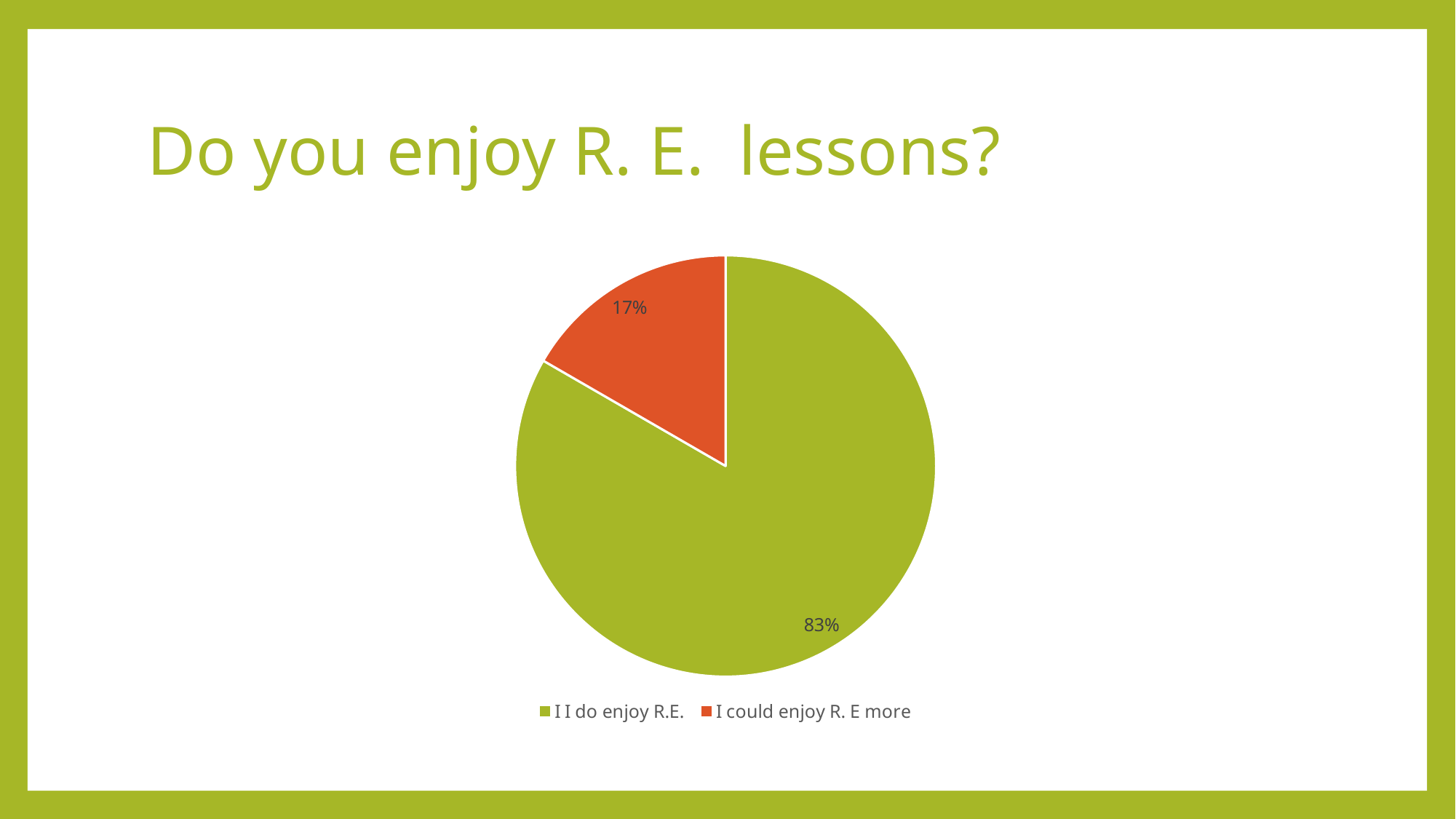
How many entries does the legend list? 2 What colour is the "I could enjoy R. E more" slice? orange Which slice of the pie is the largest? I I do enjoy R.E. What percentage of the pie is labelled for "I I do enjoy R.E."? 83% What kind of chart is shown on the slide? pie chart What is the difference in percentage points between the "I I do enjoy R.E." slice and the "I could enjoy R. E more" slice? 66 What percentage of the pie is labelled for "I could enjoy R. E more"? 17% How many slices does the pie chart have? 2 What share of the pie does the "I could enjoy R. E more" slice represent? 17% Which slice of the pie is the smallest? I could enjoy R. E more What is the title of the slide containing the pie chart? Do you enjoy R. E. lessons? Which is larger: the "I I do enjoy R.E." slice or the "I could enjoy R. E more" slice? I I do enjoy R.E.